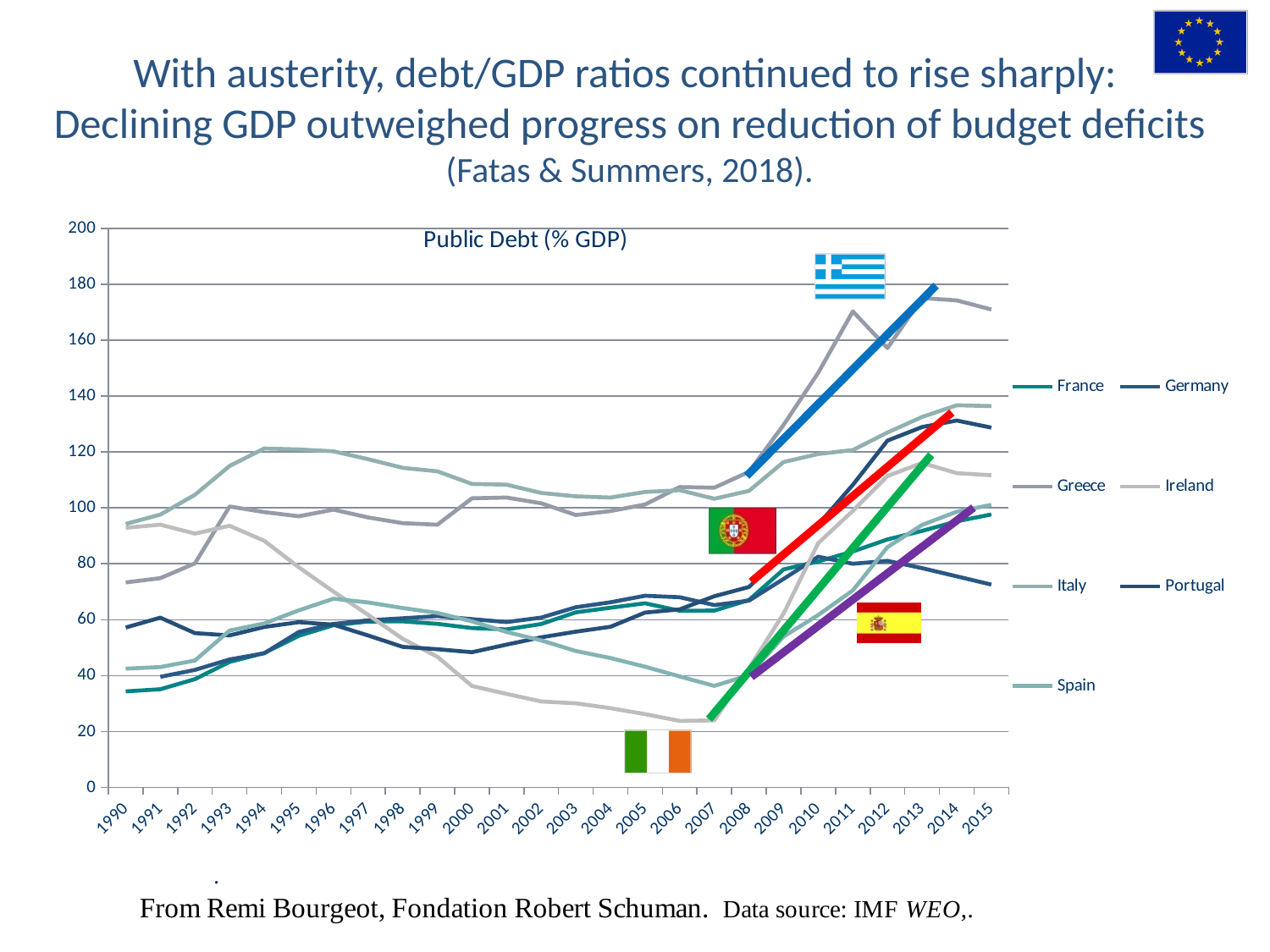
Which is larger in 2015, the value for Spain or the value for Germany? Spain What kind of chart is shown on the slide? line chart Is the value for Portugal in 2013 greater or less than 120? greater Is the value for Greece in 2015 greater or less than 160? greater Is the value for Ireland in 2007 greater or less than 40? less How many years are shown along the x axis? 26 Does the value for Greece rise or fall between 2008 and 2011? rise Which country has the lowest public debt ratio in 2015? Germany Which country has the highest public debt ratio in 2015? Greece Does the value for Ireland rise or fall between 1993 and 2007? fall What is the title printed inside the chart area? Public Debt (% GDP) How many countries does the legend list? 7